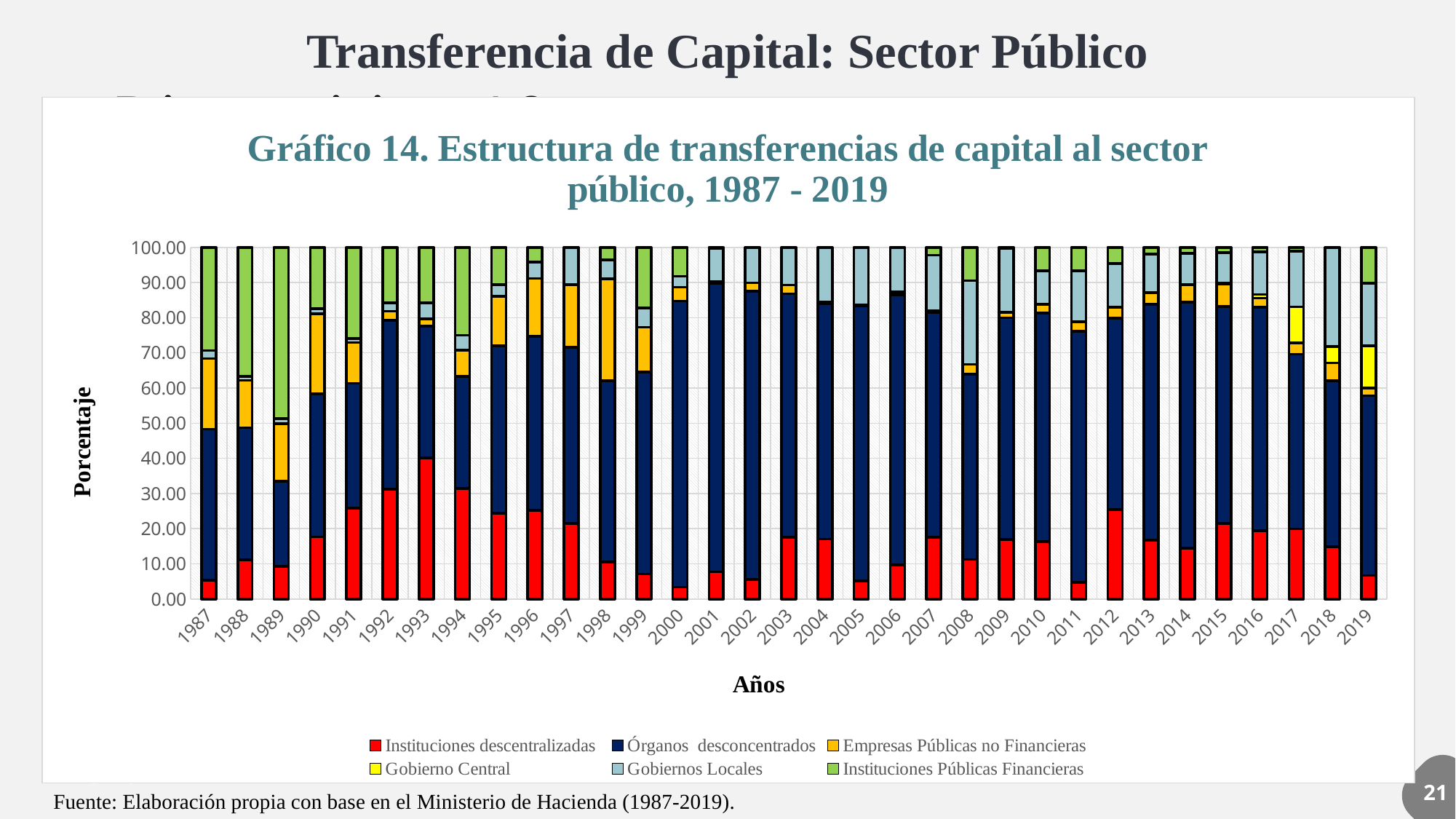
Which is larger, the Instituciones descentralizadas share in 1992 or in 1993? 1993 Is the value for Instituciones descentralizadas in 1993 greater or less than 30? greater Is the value for Instituciones descentralizadas in 2000 greater or less than 10? less How many years are shown along the x axis? 33 How many series does the legend list? 6 What is the label of the y axis? Porcentaje Does the share for Instituciones Públicas Financieras generally rise or fall from 1987 to 2019? fall Which series is shown in yellow in the legend? Gobierno Central Which year has the largest share for Instituciones descentralizadas? 1993 What kind of chart is shown on the slide? Stacked bar chart Is the value for Instituciones descentralizadas in 2012 greater or less than 20? greater Which is larger, the Instituciones descentralizadas share in 2012 or in 2013? 2012